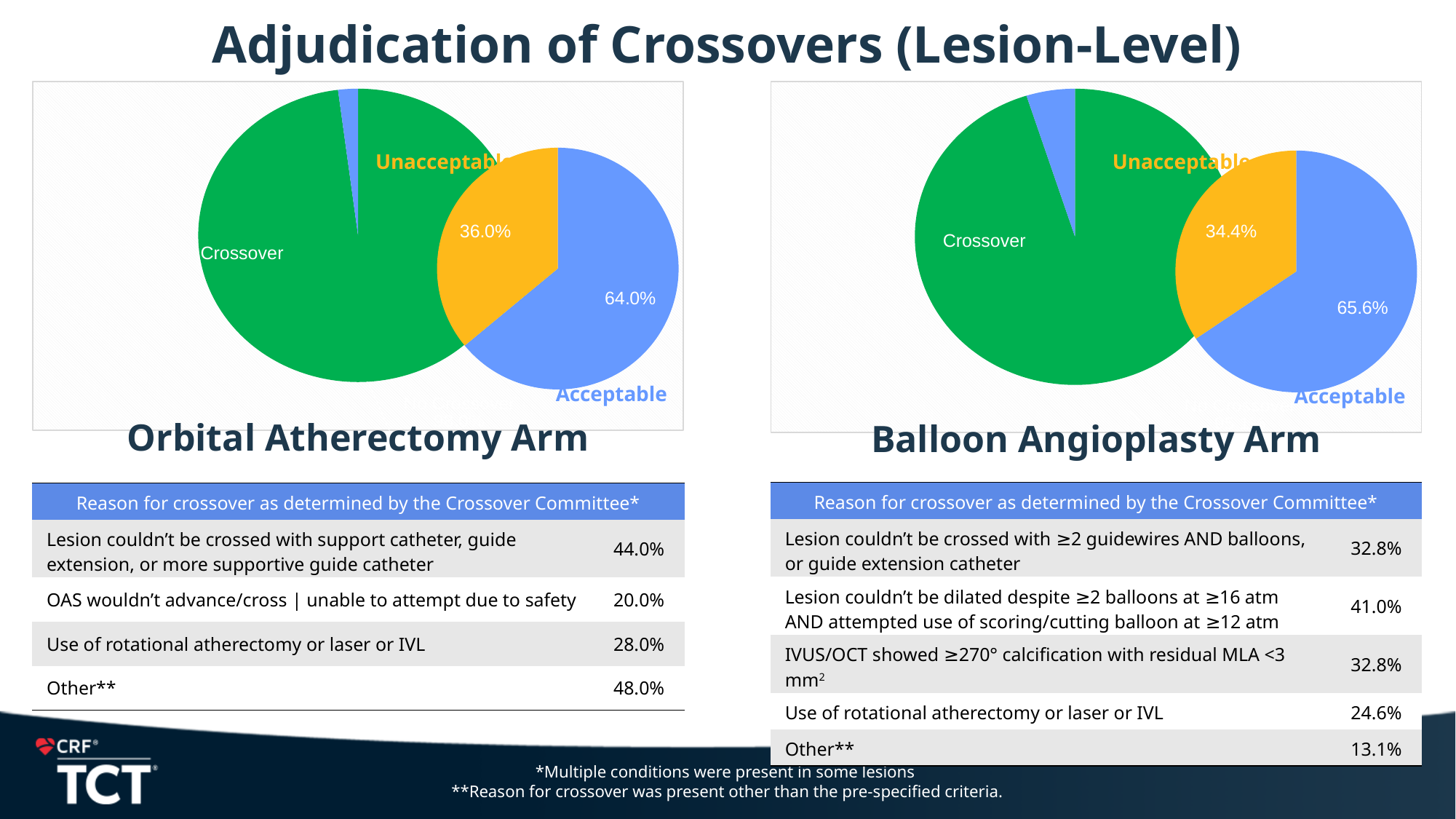
In the Balloon Angioplasty Arm chart, what share of crossovers was adjudicated as Unacceptable? 34.4% Which arm has the higher Acceptable share, Orbital Atherectomy or Balloon Angioplasty? Balloon Angioplasty In the Orbital Atherectomy Arm chart, which adjudication category is larger, Acceptable or Unacceptable? Acceptable In the Orbital Atherectomy Arm chart, what share of crossovers was adjudicated as Acceptable? 64.0% What type of chart is used to show the adjudication of crossovers on this slide? Pie chart In the Orbital Atherectomy Arm chart, what is the difference between the Acceptable and Unacceptable shares? 28.0% In the Balloon Angioplasty Arm chart, which adjudication category is smaller, Acceptable or Unacceptable? Unacceptable What colour represents the Acceptable category in the pie charts? Blue In the Orbital Atherectomy Arm chart, what share of crossovers was adjudicated as Unacceptable? 36.0% In the Balloon Angioplasty Arm chart, what share of crossovers was adjudicated as Acceptable? 65.6% In the Balloon Angioplasty Arm chart, what is the difference between the Acceptable and Unacceptable shares? 31.2%